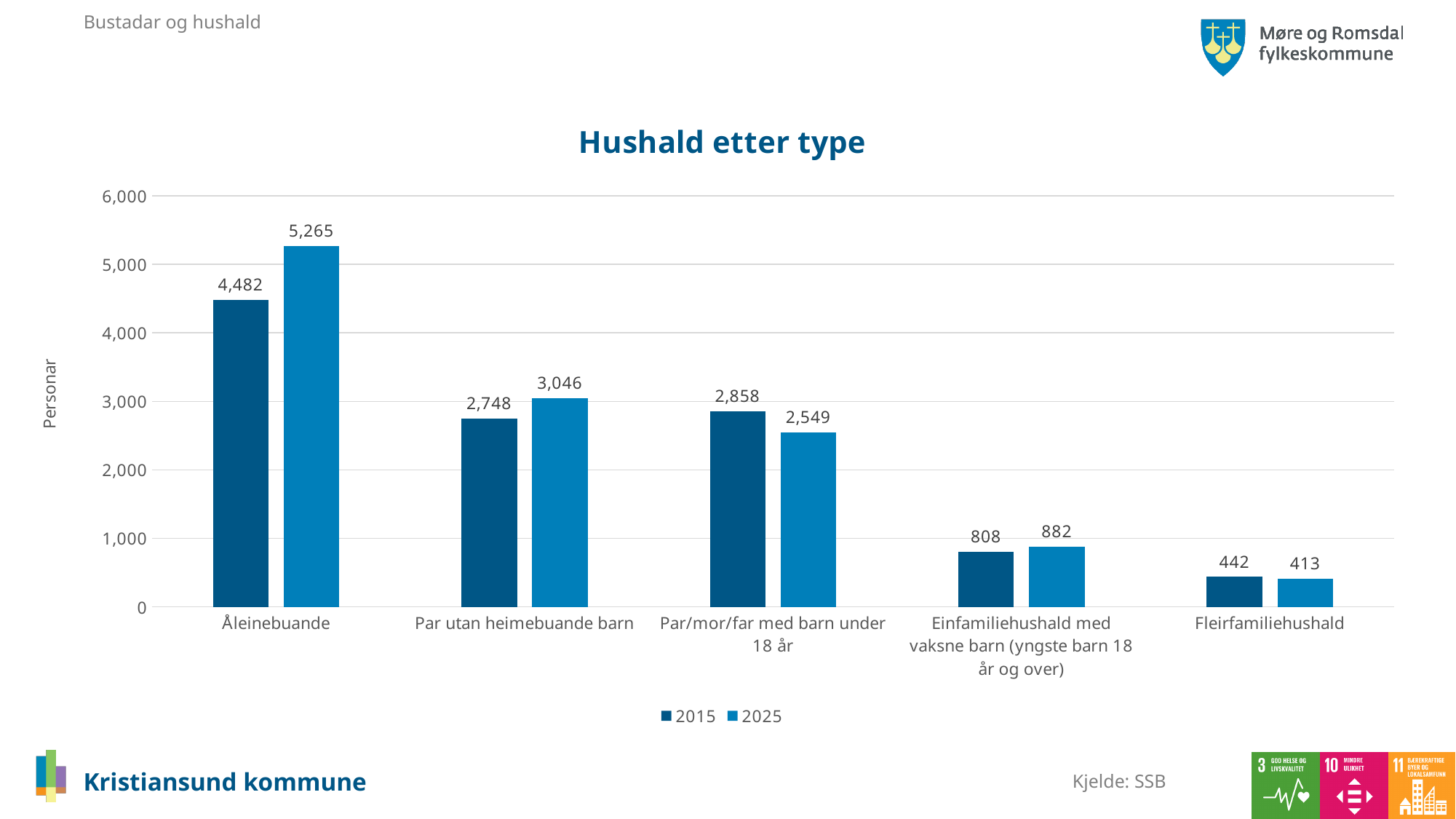
What is the title of the chart? Hushald etter type How many categories are shown on the x axis? 5 What is the 2025 value for Åleinebuande? 5,265 Which category has the highest 2015 value? Åleinebuande What is the difference between the 2025 and 2015 values for Åleinebuande? 783 What is the 2015 value for Par utan heimebuande barn? 2,748 What is the 2025 value for Fleirfamiliehushald? 413 What is the difference between the 2015 and 2025 values for Par/mor/far med barn under 18 år? 309 Which is larger for Par/mor/far med barn under 18 år, the 2015 value or the 2025 value? 2015 Which category has the lowest 2025 value? Fleirfamiliehushald How many series does the legend list? 2 What kind of chart is shown? Bar chart